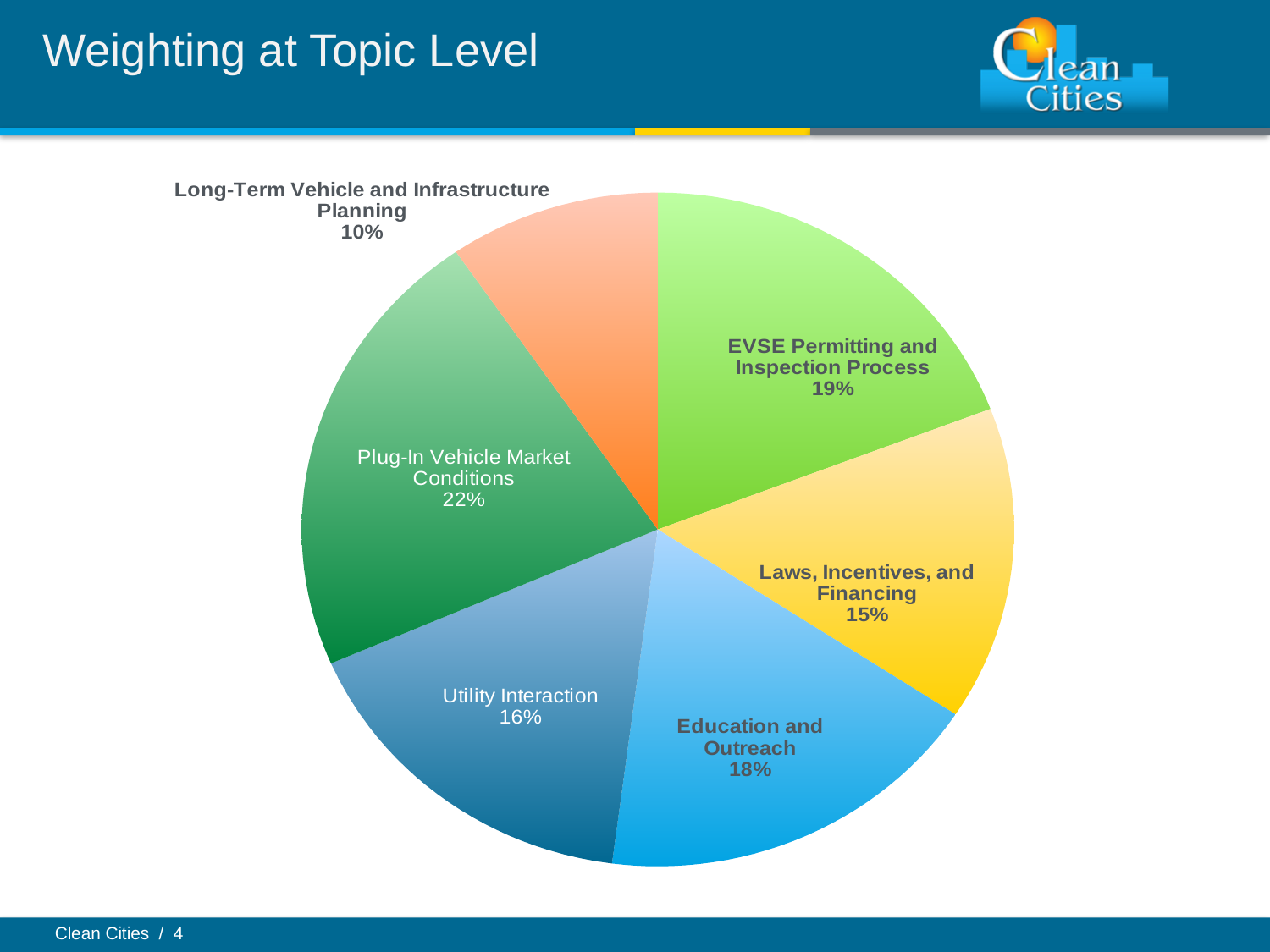
Which has a larger weighting, Education and Outreach or Utility Interaction? Education and Outreach How many topics are shown in the pie chart? 6 Which topic has the largest share of the pie? Plug-In Vehicle Market Conditions What is the weighting for Long-Term Vehicle and Infrastructure Planning? 10% What is the weighting for Utility Interaction? 16% Which topic has the smallest share of the pie? Long-Term Vehicle and Infrastructure Planning What kind of chart is shown on the slide? pie chart What is the weighting for Plug-In Vehicle Market Conditions? 22% What is the difference between the weightings for Plug-In Vehicle Market Conditions and Laws, Incentives, and Financing? 7% What colour is the Laws, Incentives, and Financing slice? yellow What is the weighting for EVSE Permitting and Inspection Process? 19% What is the title of the slide containing the pie chart? Weighting at Topic Level